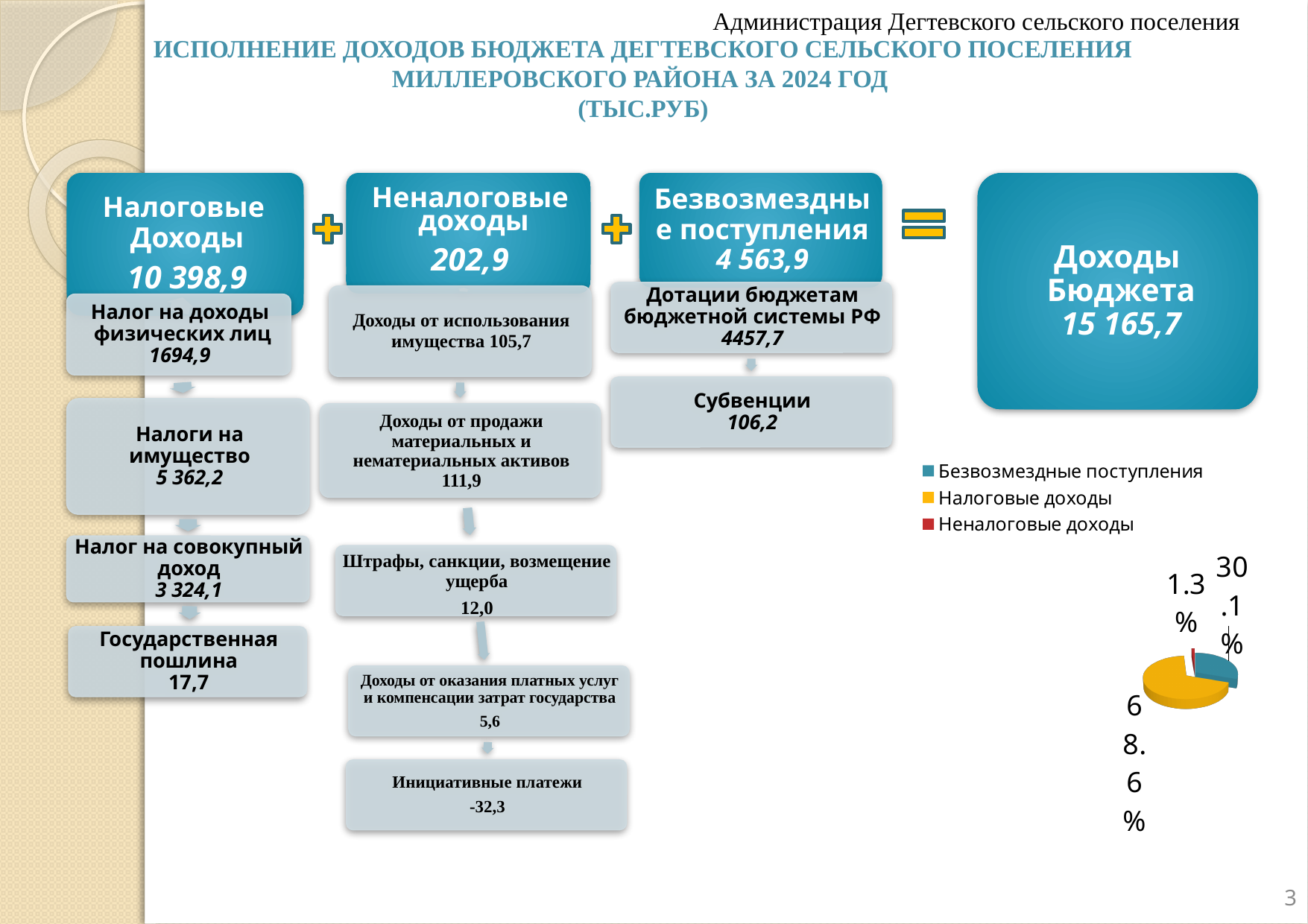
In the pie chart, which is larger: Безвозмездные поступления or Неналоговые доходы? Безвозмездные поступления What colour represents Неналоговые доходы in the pie chart? red In the pie chart, what share is shown for Неналоговые доходы? 1.3% In the pie chart, what is the difference in percentage points between the shares of Налоговые доходы and Безвозмездные поступления? 38.5% Which category has the largest slice in the pie chart? Налоговые доходы What kind of chart is shown at the bottom right of the slide? pie chart What colour represents Налоговые доходы in the pie chart? yellow How many slices does the pie chart have? 3 Which category has the smallest slice in the pie chart? Неналоговые доходы In the pie chart, what share is shown for Безвозмездные поступления? 30.1% How many entries does the legend of the pie chart list? 3 In the pie chart, what share is shown for Налоговые доходы? 68.6%